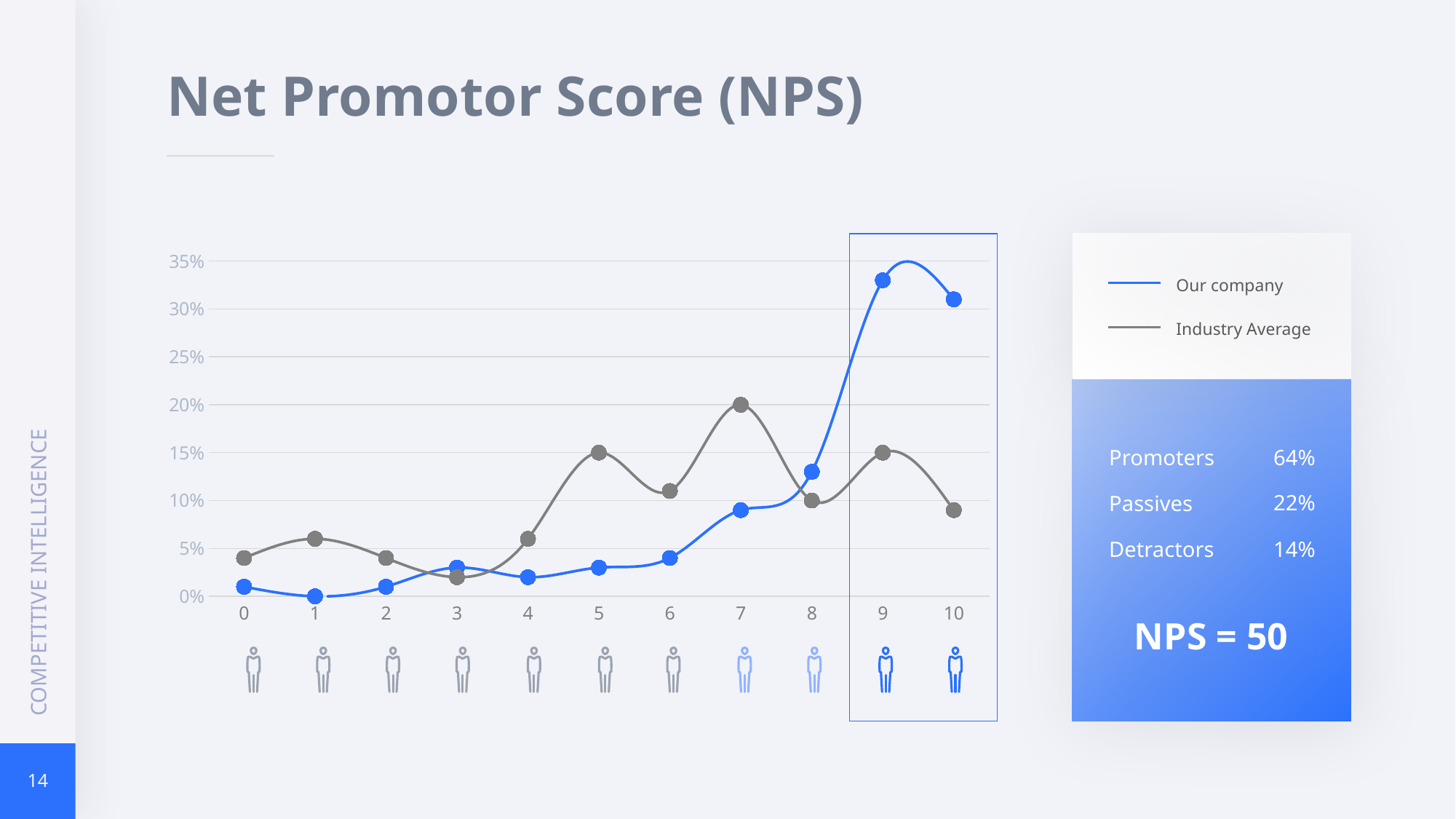
At which score is the Our company series lowest? 1 What kind of chart is shown on the slide? line chart At which score does the Our company series reach its highest value? 9 Is the Our company value at score 9 greater or less than 30%? greater At which score does the Industry Average series reach its highest value? 7 How many points are plotted along the x axis for each series? 11 How many series does the chart legend list? 2 What is the Industry Average value at score 7? 20% What are the two series named in the chart legend? Our company and Industry Average At score 5, which series has the larger value, Our company or Industry Average? Industry Average What is the Our company value at score 1? 0% What is the Industry Average value at score 5? 15%